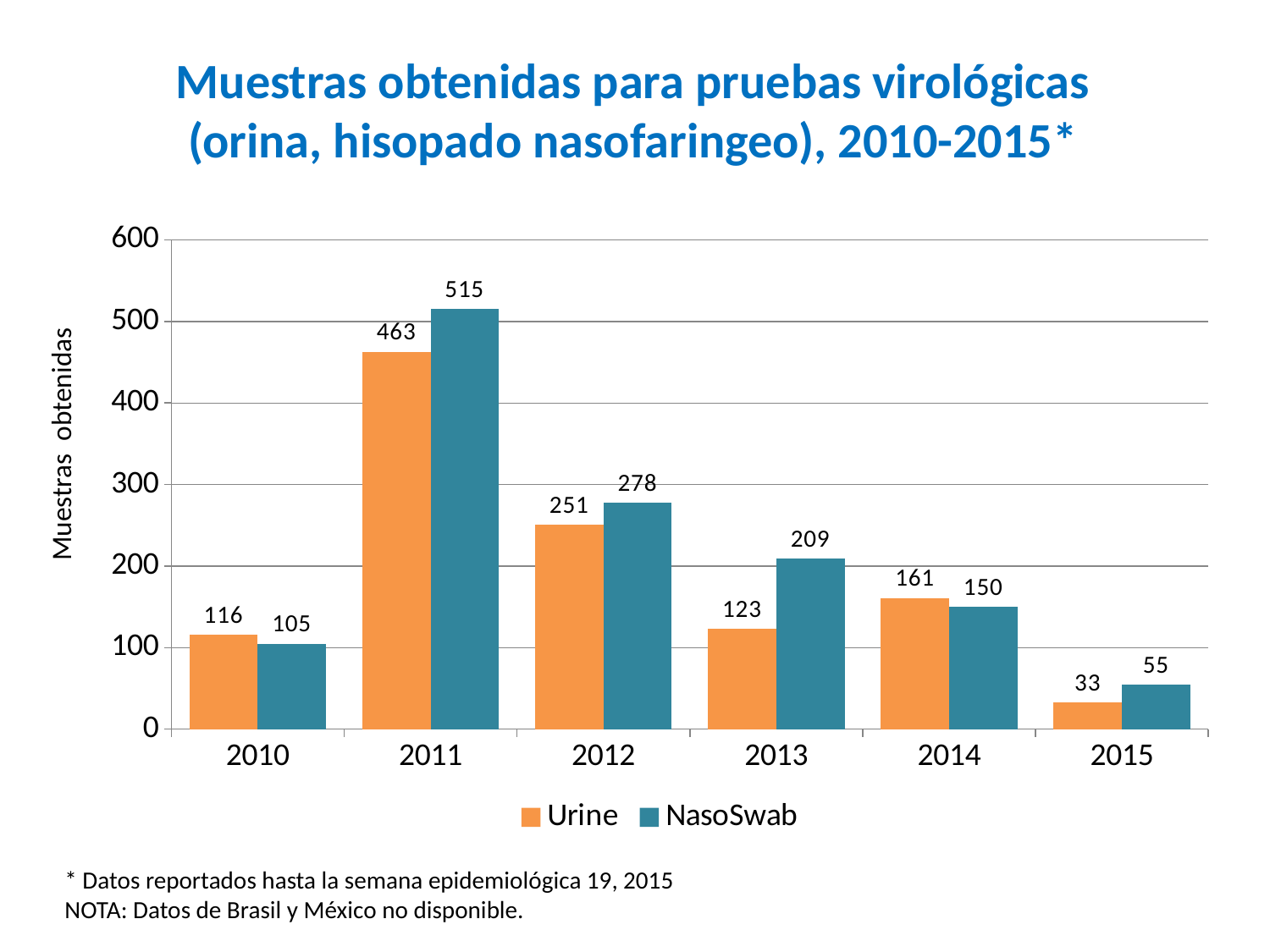
What is the Urine value for 2015? 33 What kind of chart is shown on the slide? bar chart What is the NasoSwab value for 2013? 209 Which year has the lowest Urine value? 2015 How many years are shown on the x axis? 6 Is the NasoSwab value for 2012 greater or less than 200? greater Which year has the highest NasoSwab value? 2011 What is the Urine value for 2011? 463 What is the difference between the NasoSwab and Urine values in 2011? 52 Which colour represents the NasoSwab series? teal blue How many series does the legend list? 2 Which is larger in 2014, the Urine value or the NasoSwab value? Urine